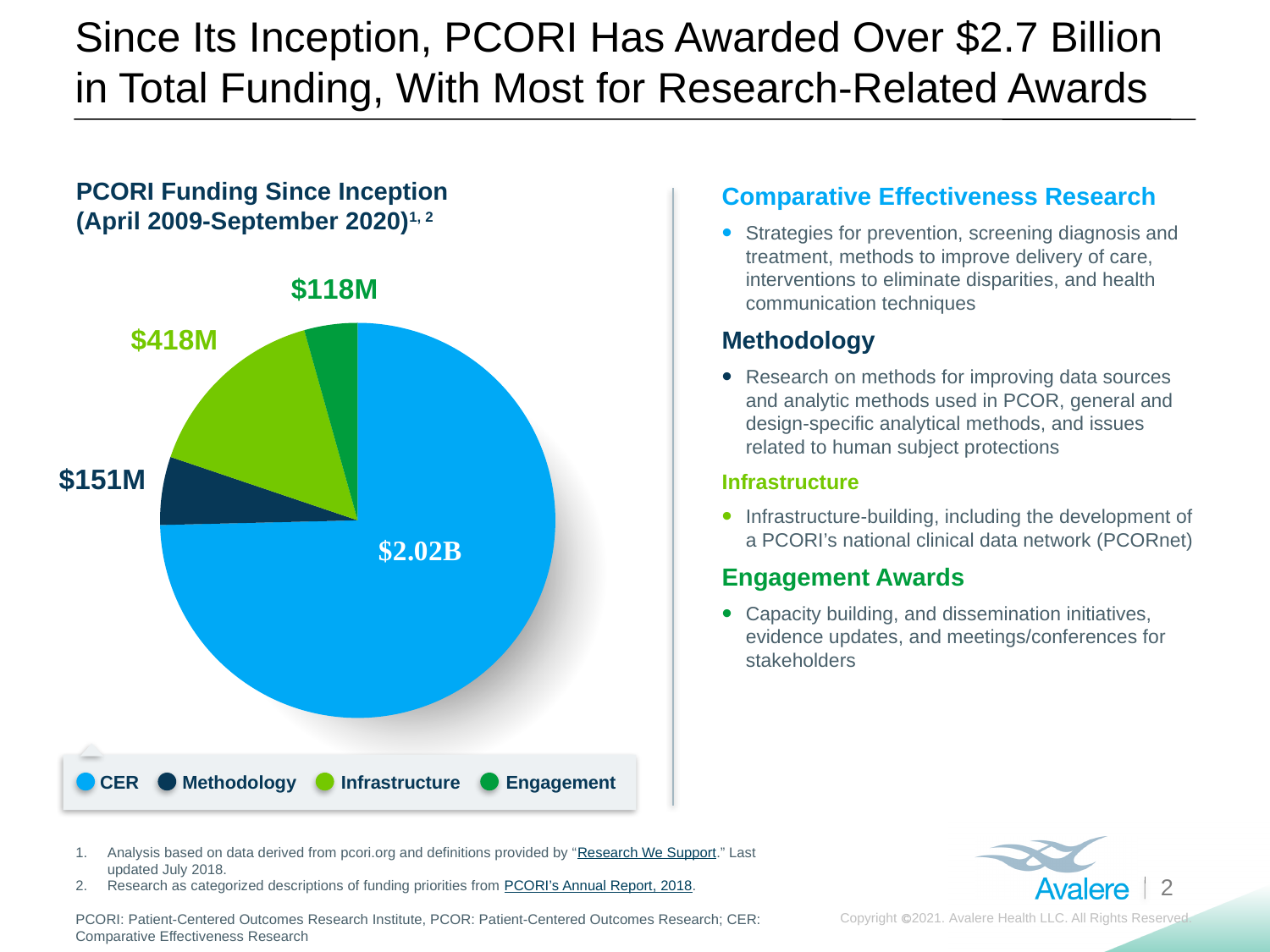
Which received more funding, Infrastructure or Methodology? Infrastructure What is the funding value for Infrastructure in the pie chart? $418M What is the funding value for CER in the pie chart? $2.02B Which category received the most funding in the pie chart? CER How many categories are shown in the pie chart? 4 What is the funding value for Engagement in the pie chart? $118M What is the difference between the Methodology and Engagement funding values? $33M What is the funding value for Methodology in the pie chart? $151M Which category received the least funding in the pie chart? Engagement What is the title of the pie chart? PCORI Funding Since Inception (April 2009-September 2020) What is the difference between the Infrastructure and Methodology funding values? $267M What kind of chart is shown on the slide? Pie chart